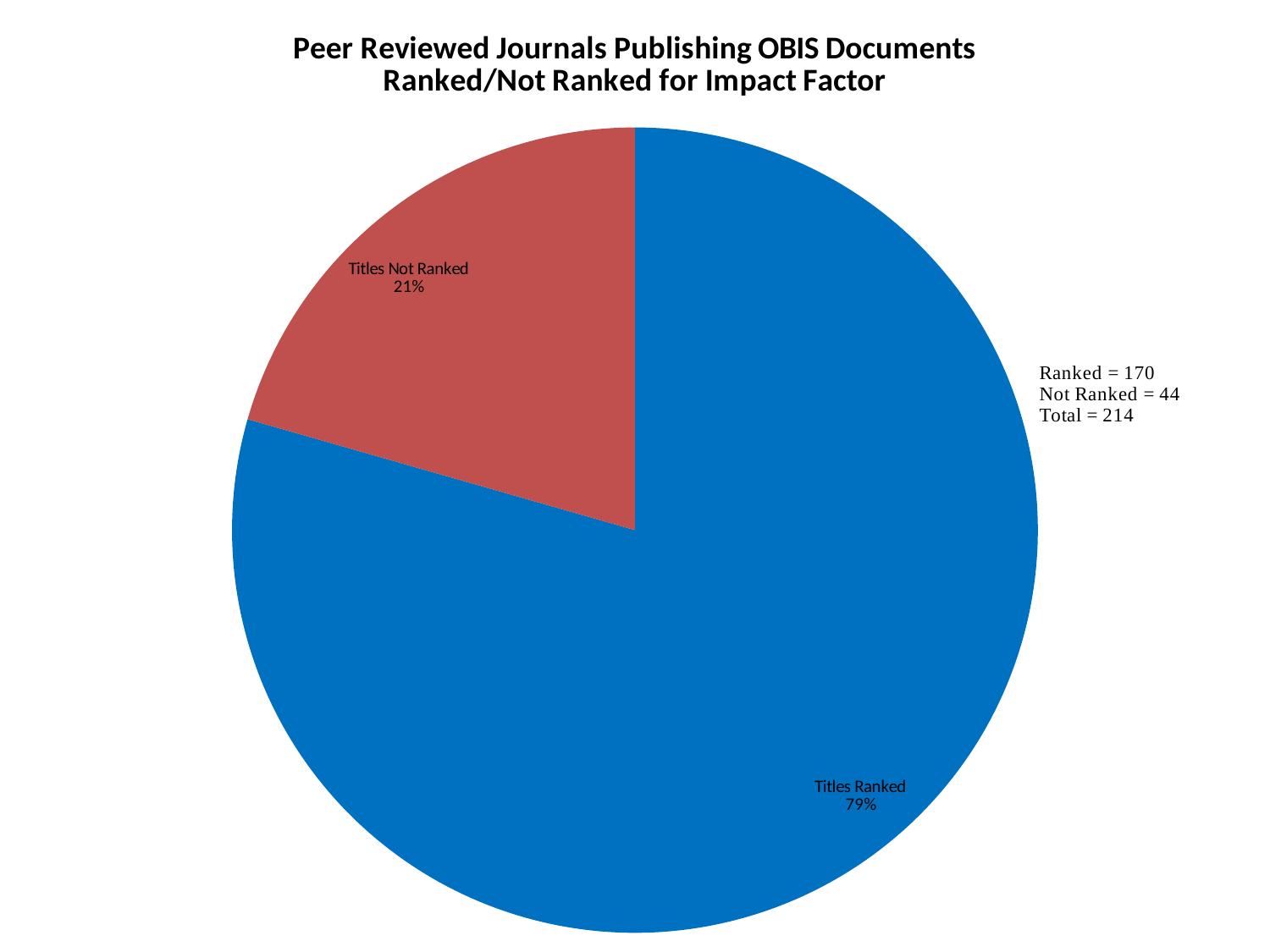
What type of chart is shown on the slide? pie chart Which slice is the largest? Titles Ranked What share of the pie is labelled Titles Not Ranked? 21% What is the difference in percentage points between the Titles Ranked and Titles Not Ranked slices? 58 What colour is the Titles Not Ranked slice? red According to the text beside the chart, how many journals are Not Ranked? 44 How many slices does the pie chart have? 2 What share of the pie is labelled Titles Ranked? 79% Which slice is the smallest? Titles Not Ranked What is the total number of journals given beside the chart? 214 According to the text beside the chart, how many journals are Ranked? 170 Which slice is larger, Titles Ranked or Titles Not Ranked? Titles Ranked